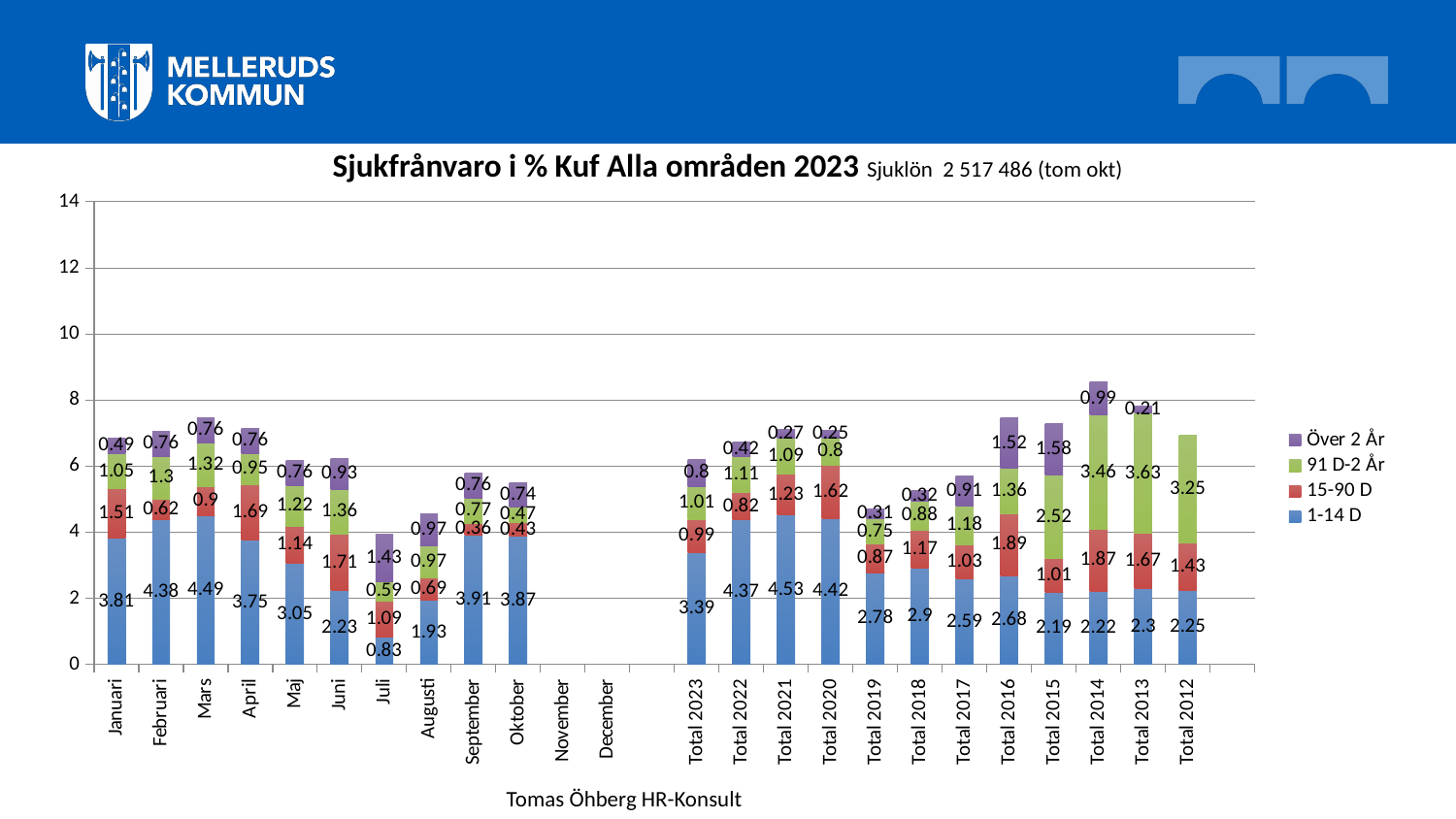
What is the value of the 91 D-2 År series for Total 2014? 3.46 What is the value of the 1-14 D series for Januari? 3.81 Does the 1-14 D series rise or fall from Mars to Juli? Fall What is the total of the stacked bar for Januari? 6.86 Which category has the highest value for the 91 D-2 År series? Total 2013 Which is larger, the 91 D-2 År value for Total 2014 or for Total 2012? Total 2014 What is the value of the Över 2 År series for Juli? 1.43 How many series does the legend list? 4 What is the difference between the 1-14 D values for Januari and Juli? 2.98 Which category has the lowest value for the 1-14 D series? Juli Is the total height of the stacked bar for Total 2014 greater or less than 8? greater What kind of chart is shown on the slide? Stacked bar chart